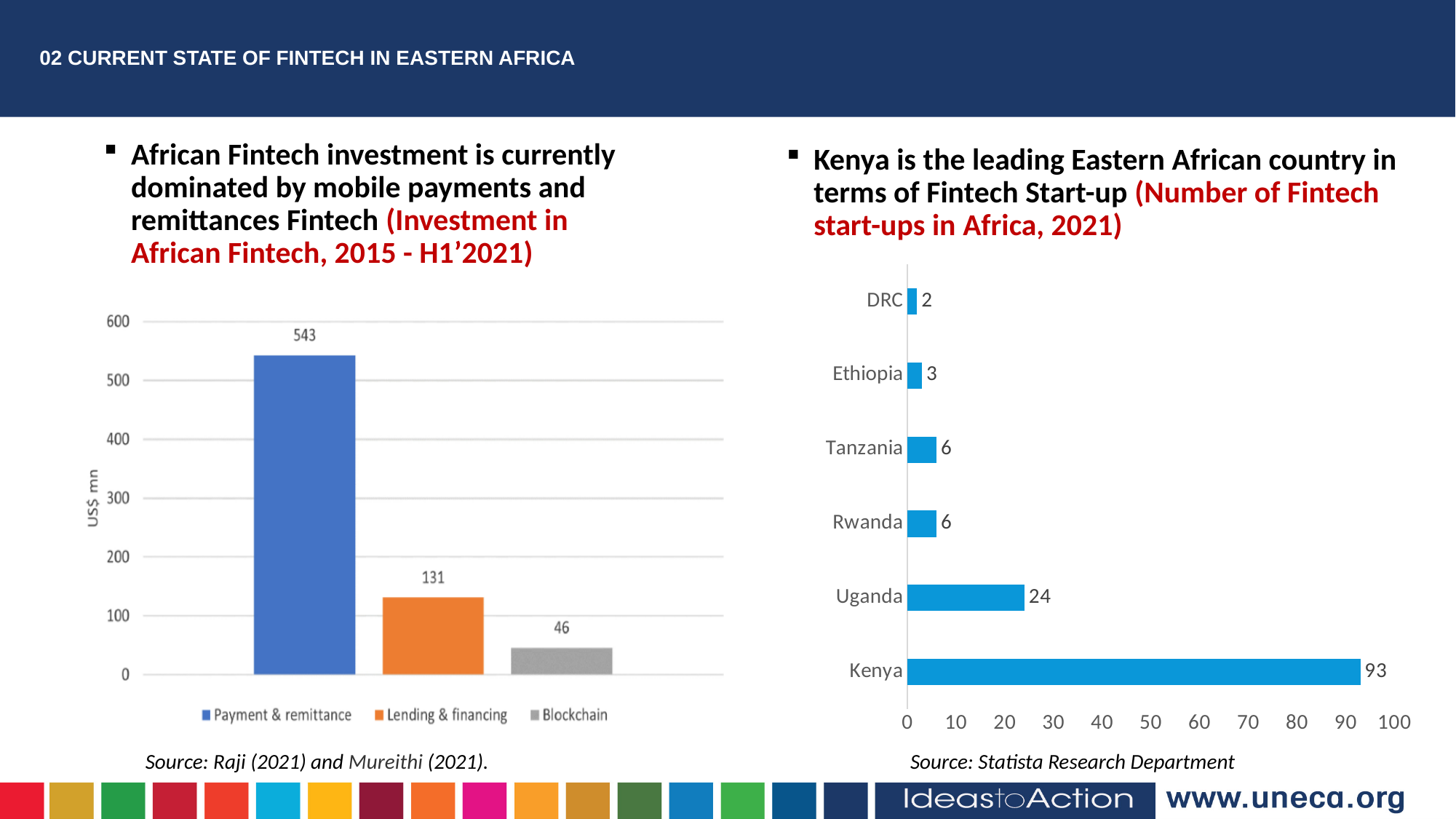
In the left chart (Investment in African Fintech, 2015 - H1'2021), how many entries does the legend list? 3 In the right chart (Number of Fintech start-ups in Africa, 2021), which country has the lowest value? DRC What kind of chart is the right chart (Number of Fintech start-ups in Africa, 2021)? Bar chart In the right chart (Number of Fintech start-ups in Africa, 2021), what is the value for Uganda? 24 In the left chart (Investment in African Fintech, 2015 - H1'2021), what is the value for Payment & remittance? 543 In the right chart (Number of Fintech start-ups in Africa, 2021), how many countries are shown? 6 In the right chart (Number of Fintech start-ups in Africa, 2021), what is the difference between Kenya and Uganda? 69 In the right chart (Number of Fintech start-ups in Africa, 2021), which country has the highest value? Kenya In the left chart (Investment in African Fintech, 2015 - H1'2021), what is the y-axis label? US$ mn In the left chart (Investment in African Fintech, 2015 - H1'2021), what is the value for Blockchain? 46 In the left chart (Investment in African Fintech, 2015 - H1'2021), which category has the lowest value? Blockchain In the left chart (Investment in African Fintech, 2015 - H1'2021), what is the difference between Payment & remittance and Lending & financing? 412